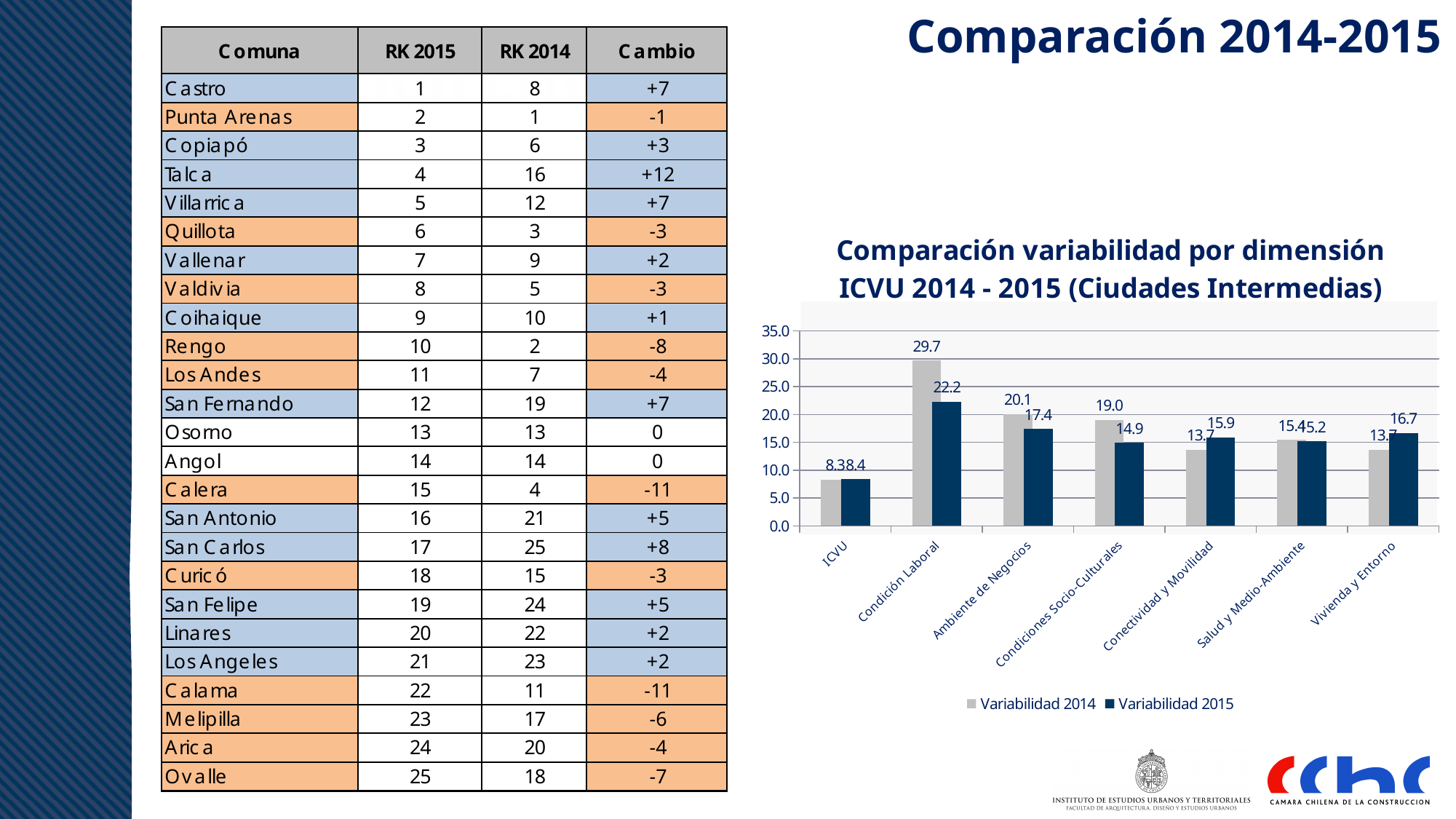
What is the Variabilidad 2015 value for Ambiente de Negocios? 17.4 Which dimension has the lowest Variabilidad 2015 value? ICVU What is the Variabilidad 2015 value for Condición Laboral? 22.2 For Conectividad y Movilidad, which is larger: Variabilidad 2014 or Variabilidad 2015? Variabilidad 2015 What kind of chart is shown on the slide? bar chart Which dimension has the highest Variabilidad 2014 value? Condición Laboral What are the two legend entries of the chart? Variabilidad 2014 and Variabilidad 2015 What is the Variabilidad 2014 value for Condición Laboral? 29.7 What is the difference between the Variabilidad 2014 and Variabilidad 2015 values for Condición Laboral? 7.5 How many dimensions (categories) are shown on the x axis of the chart? 7 How many series does the legend of the chart list? 2 Is the Variabilidad 2014 value for ICVU greater or less than 10.0? less